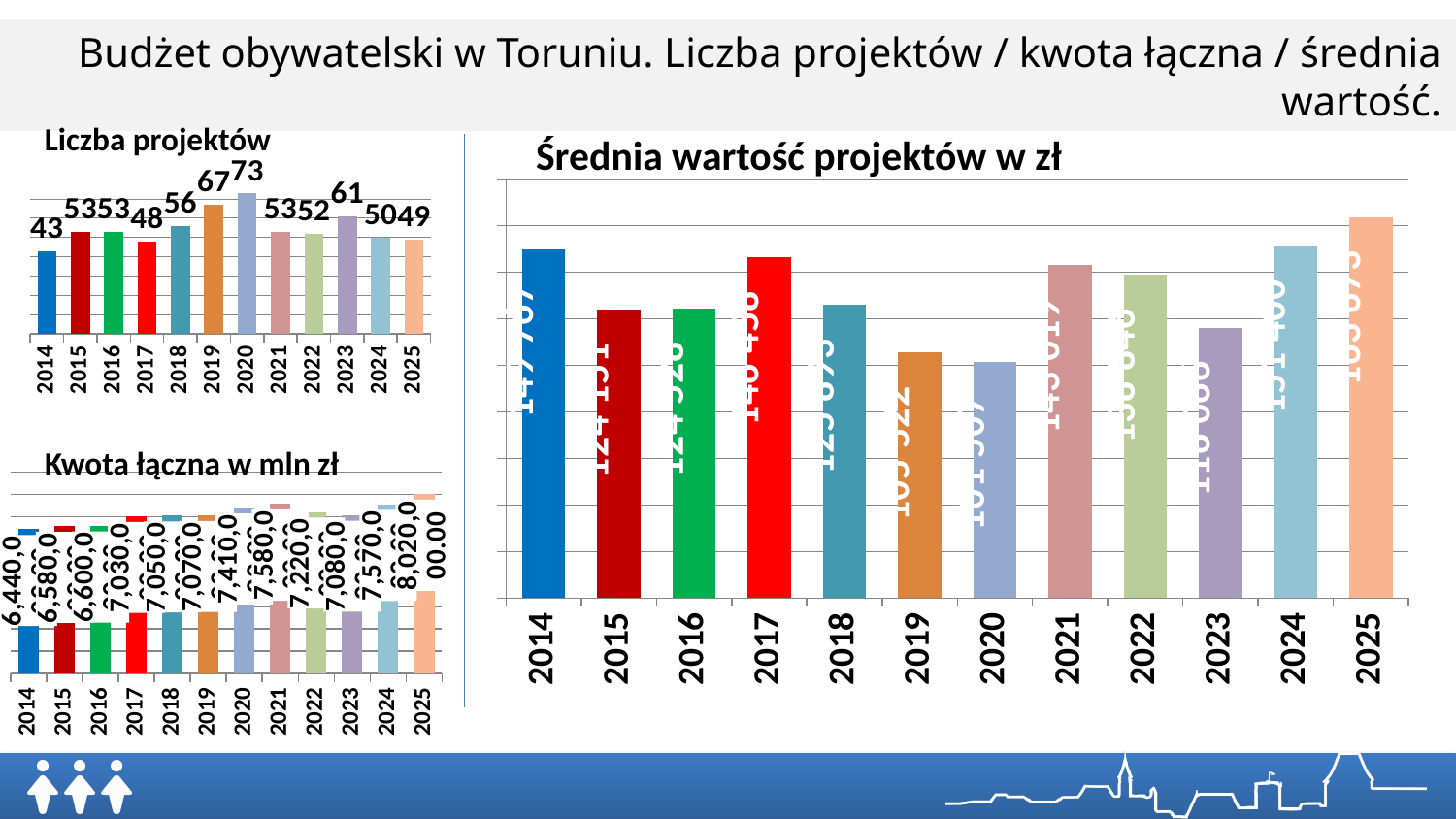
In the 'Liczba projektów' chart, which is larger, the value for 2018 or the value for 2017? 2018 In the 'Średnia wartość projektów w zł' chart, which is larger, the value for 2014 or the value for 2017? 2014 In the 'Liczba projektów' chart, which year has the lowest number of projects? 2014 What kind of chart is the 'Średnia wartość projektów w zł' chart? bar chart How many years are shown on the x axis of the 'Średnia wartość projektów w zł' chart? 12 In the 'Średnia wartość projektów w zł' chart, which year has the highest bar? 2025 In the 'Liczba projektów' chart, what is the value for 2014? 43 In the 'Liczba projektów' chart, what is the value for 2023? 61 In the 'Liczba projektów' chart, what is the difference between the values for 2020 and 2014? 30 In the 'Liczba projektów' chart, which year has the highest number of projects? 2020 In the 'Liczba projektów' chart, what is the value for 2020? 73 In the 'Średnia wartość projektów w zł' chart, which year has the lowest bar? 2020